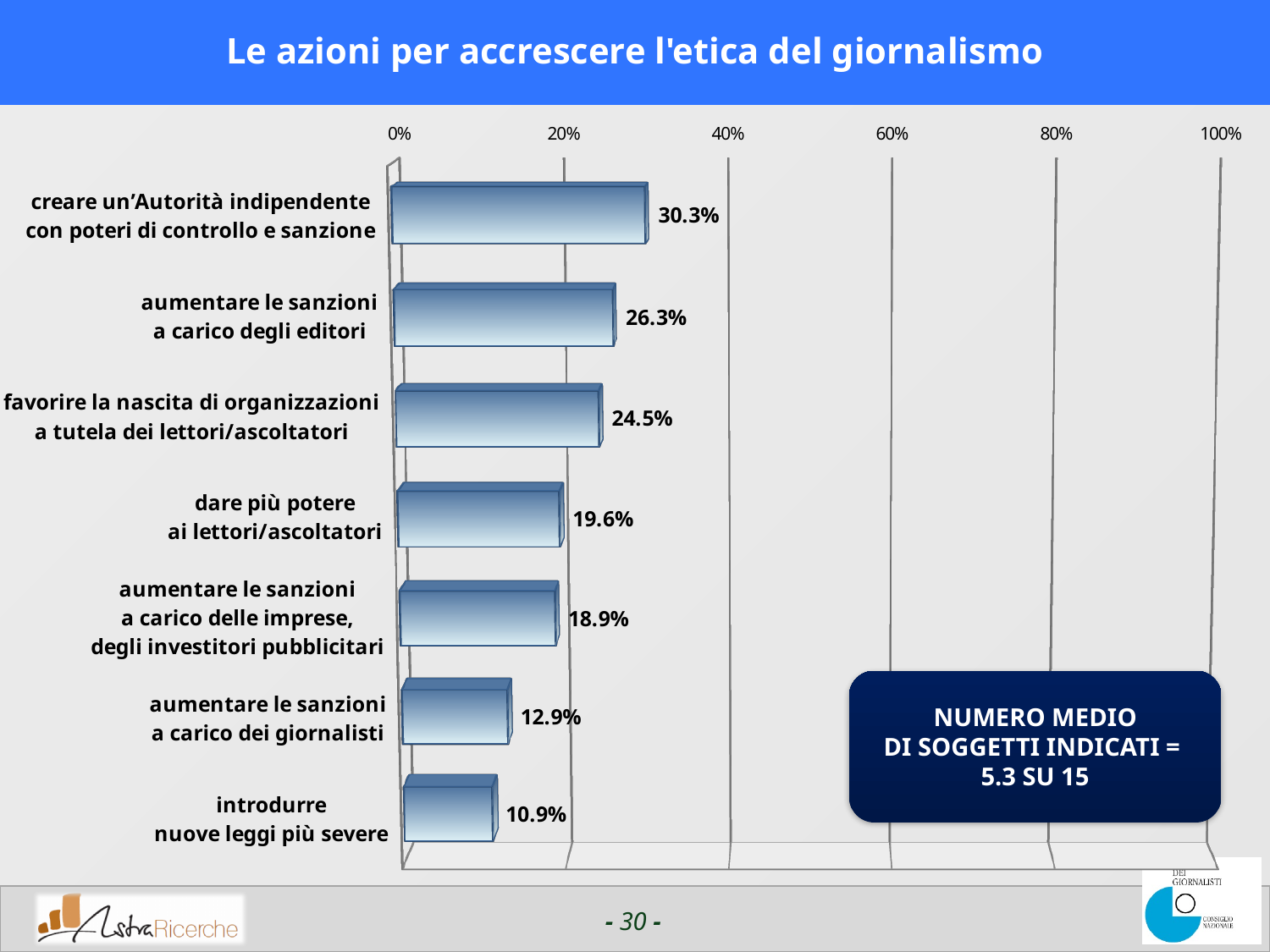
What is the average number of subjects indicated, according to the box on the chart? 5.3 su 15 How many categories are shown in the chart? 7 What is the value for 'creare un'Autorità indipendente con poteri di controllo e sanzione'? 30.3% Is the value for 'aumentare le sanzioni a carico degli editori' greater or less than 20%? greater What is the value for 'dare più potere ai lettori/ascoltatori'? 19.6% What is the difference between 'aumentare le sanzioni a carico degli editori' and 'aumentare le sanzioni a carico dei giornalisti'? 13.4% Which category has the lowest value? introdurre nuove leggi più severe What is the value for 'aumentare le sanzioni a carico dei giornalisti'? 12.9% Which is larger: 'favorire la nascita di organizzazioni a tutela dei lettori/ascoltatori' or 'aumentare le sanzioni a carico delle imprese, degli investitori pubblicitari'? favorire la nascita di organizzazioni a tutela dei lettori/ascoltatori What is the title of the slide? Le azioni per accrescere l'etica del giornalismo Which category has the highest value? creare un'Autorità indipendente con poteri di controllo e sanzione What kind of chart is shown on the slide? bar chart